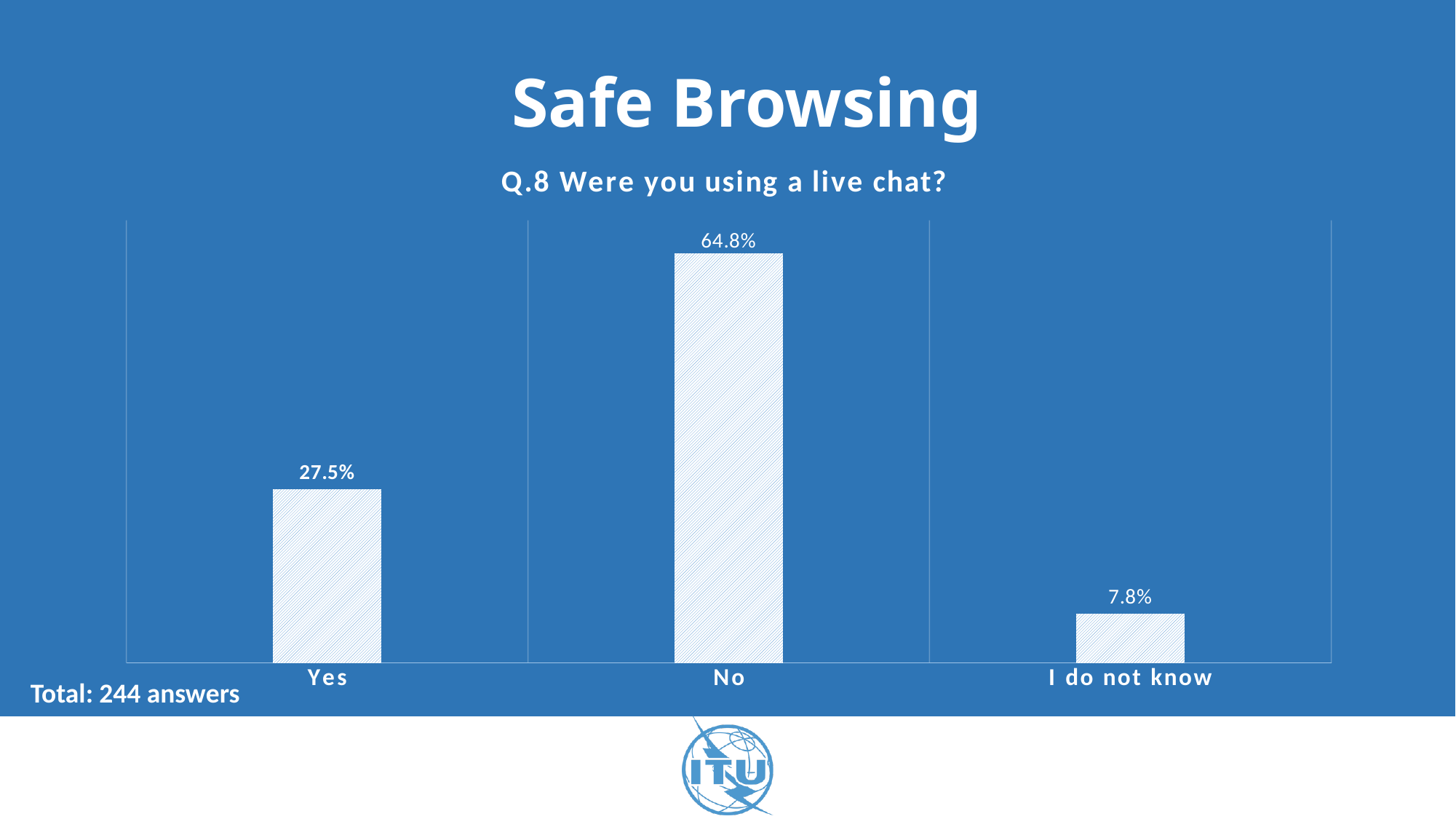
Which answer category has the highest percentage? No What type of chart is shown on the slide? Bar chart What percentage of respondents answered "I do not know"? 7.8% What percentage of respondents answered "Yes" to Q.8 Were you using a live chat? 27.5% What percentage of respondents answered "No"? 64.8% Which is larger, the percentage for "Yes" or for "I do not know"? Yes How many answer categories are shown in the chart? 3 Which answer category has the lowest percentage? I do not know What is the difference in percentage points between the "No" and "Yes" answers? 37.3 What is the difference in percentage points between the "Yes" and "I do not know" answers? 19.7 What is the title of the chart? Q.8 Were you using a live chat? How many total answers does the slide say the chart is based on? 244